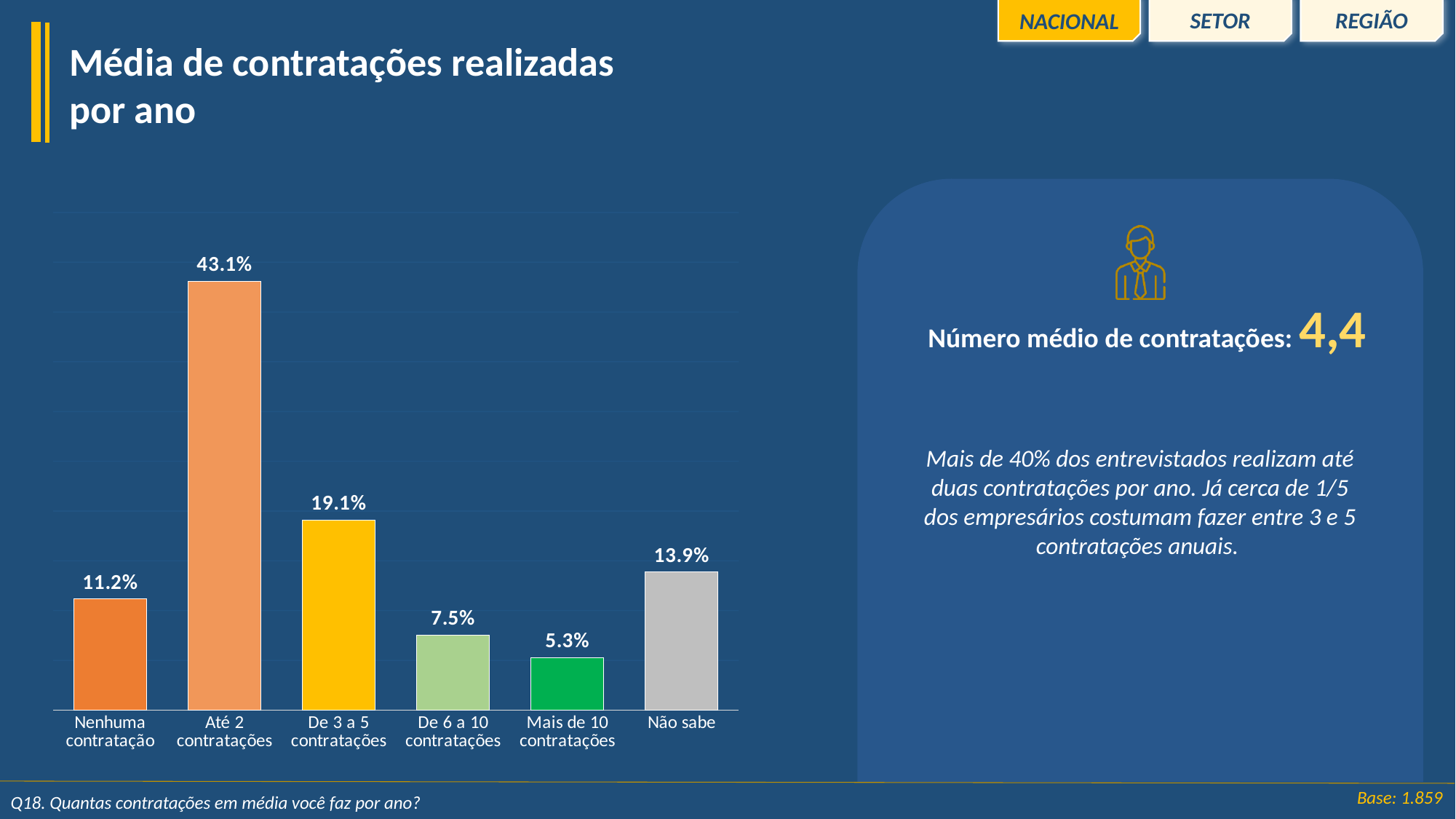
What kind of chart is shown on the slide? Bar chart What is the value for 'Não sabe'? 13.9% What is the value for 'Mais de 10 contratações'? 5.3% What is the value for 'Até 2 contratações'? 43.1% Which category has the lowest value? Mais de 10 contratações How many categories are shown in the chart? 6 What is the difference between the values for 'Até 2 contratações' and 'De 3 a 5 contratações'? 24.0% Which category has the highest value? Até 2 contratações What is the difference between the values for 'Não sabe' and 'Nenhuma contratação'? 2.7% What is the title of the slide? Média de contratações realizadas por ano What is the value for 'Nenhuma contratação'? 11.2% Which is larger, the value for 'De 6 a 10 contratações' or the value for 'Mais de 10 contratações'? De 6 a 10 contratações